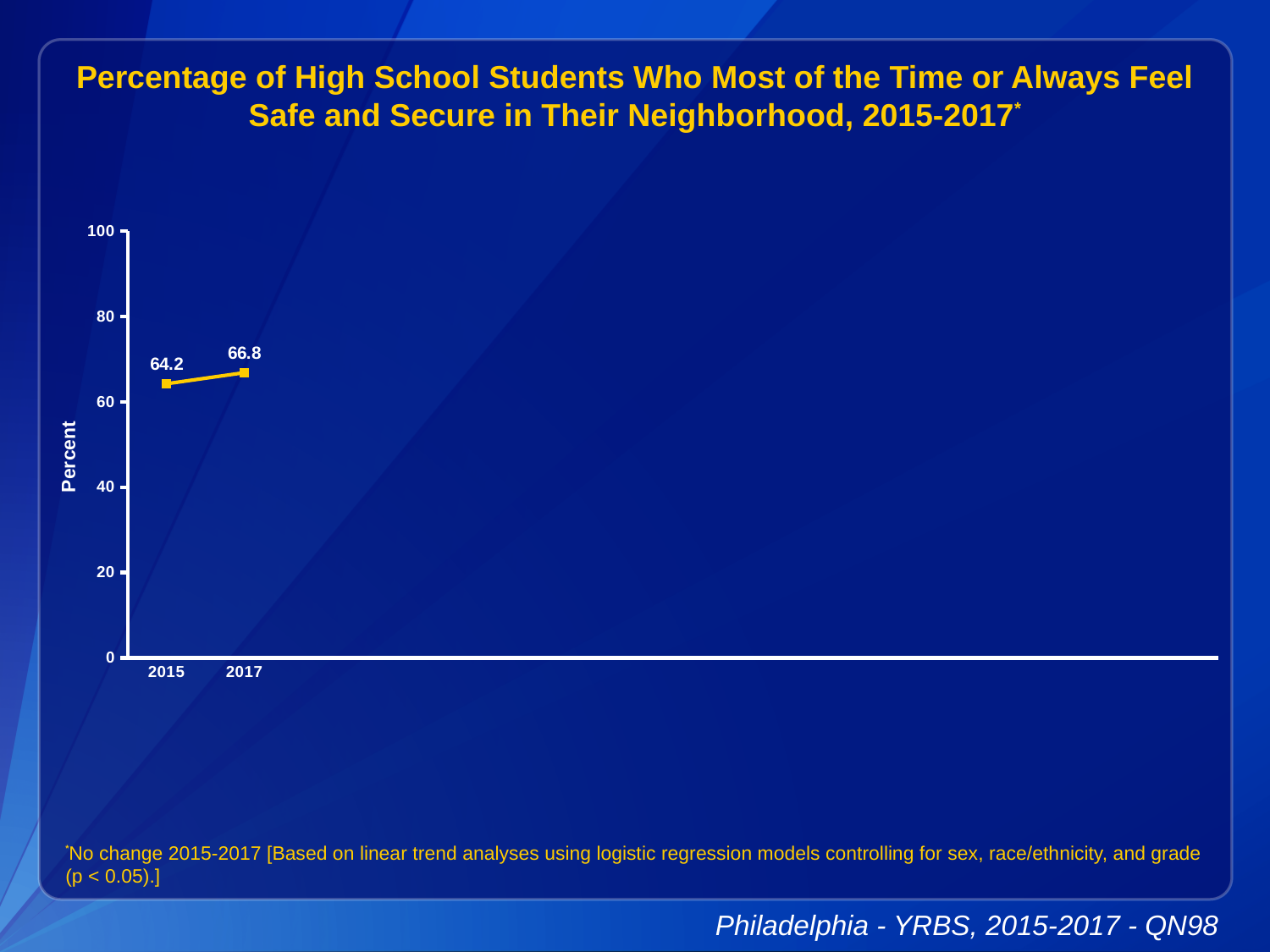
Do the values rise or fall from 2015 to 2017? rise What is the value for 2015? 64.2 What is the difference between the 2017 and 2015 values? 2.6 Is the value for 2015 greater or less than 60? greater What is the value for 2017? 66.8 Which is larger, the value for 2015 or the value for 2017? 2017 Is the value for 2017 greater or less than 80? less What kind of chart is shown on the slide? line chart Which year has the lowest value? 2015 What is the label on the vertical axis? Percent Which year has the highest value? 2017 How many data points are plotted on the chart? 2